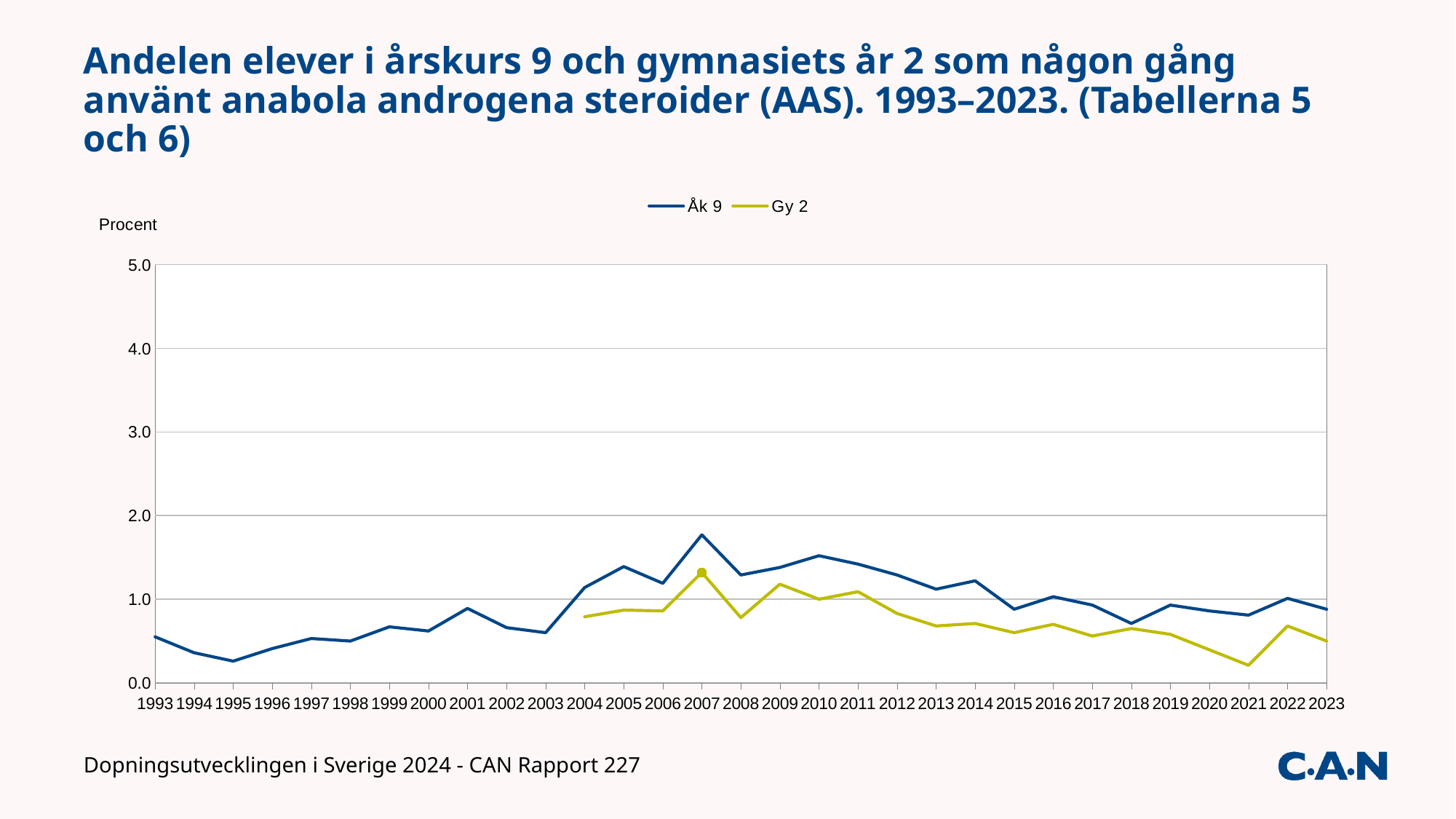
How many years are shown on the x axis? 31 In 2008, which series has the larger value, Åk 9 or Gy 2? Åk 9 How many series does the legend list? 2 What kind of chart is shown on the slide? line chart In which year does the Åk 9 series have its lowest value? 1995 In which year does the Gy 2 series have its lowest value? 2021 What is the label on the y axis? Procent Is the value for Åk 9 in 2007 greater or less than 1.0? greater In which year does the Gy 2 series reach its highest value? 2007 In which year does the Åk 9 series reach its highest value? 2007 Is the value for Gy 2 in 2021 greater or less than 1.0? less Which two series are listed in the legend? Åk 9 and Gy 2